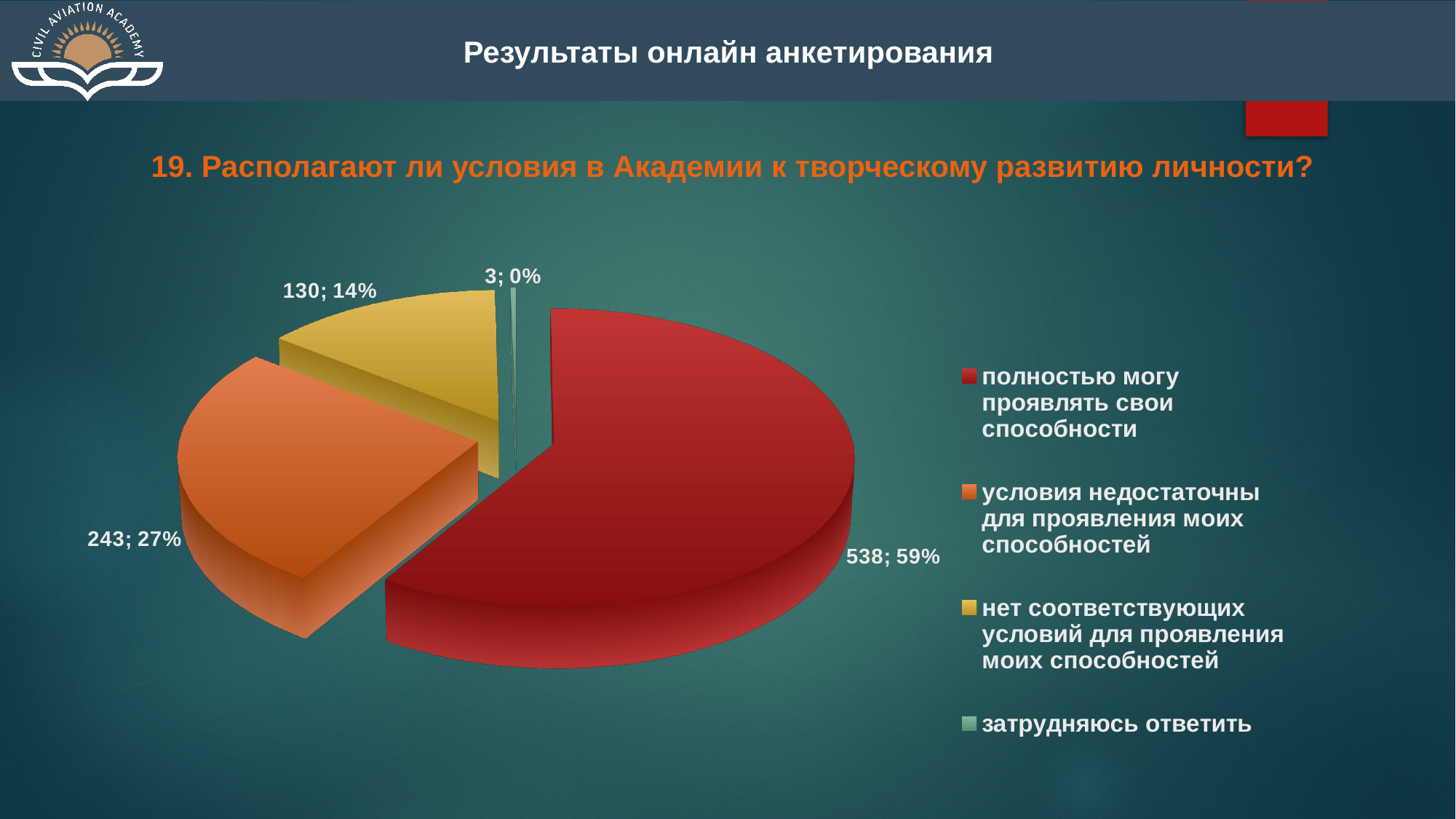
How many slices does the pie chart have? 4 Which has more respondents: "условия недостаточны для проявления моих способностей" or "нет соответствующих условий для проявления моих способностей"? условия недостаточны для проявления моих способностей How many respondents chose "нет соответствующих условий для проявления моих способностей"? 130 Which answer option has the largest slice? полностью могу проявлять свои способности What is the difference between the counts for "полностью могу проявлять свои способности" and "условия недостаточны для проявления моих способностей"? 295 How many entries does the legend list? 4 Which answer option has the smallest slice? затрудняюсь ответить What kind of chart is shown on the slide? pie chart What share of the pie does "условия недостаточны для проявления моих способностей" take? 27% What is the count for "затрудняюсь ответить"? 3 What colour is the slice for "нет соответствующих условий для проявления моих способностей"? yellow How many respondents chose "полностью могу проявлять свои способности"? 538